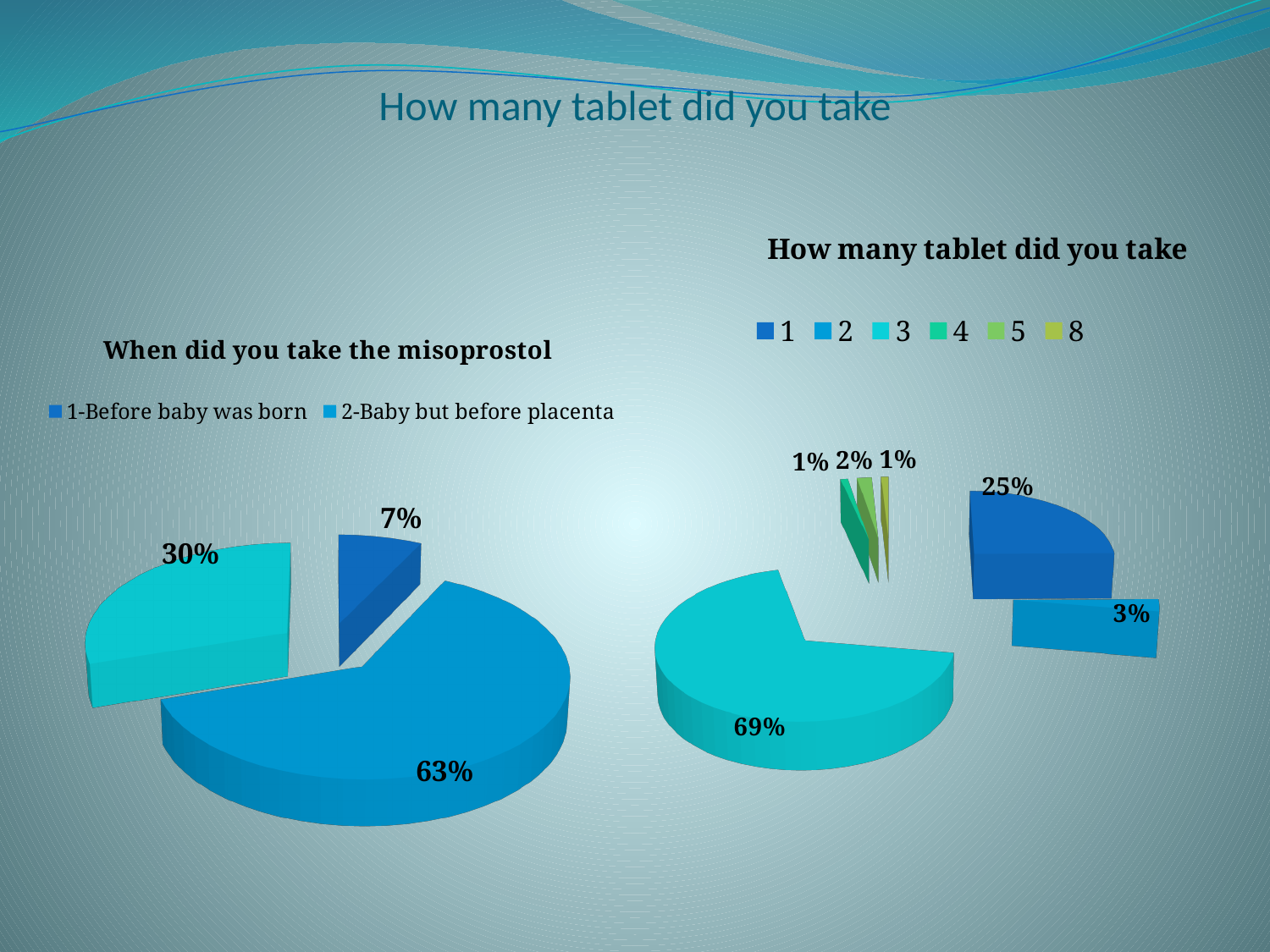
On the chart titled "When did you take the misoprostol", what share is shown for "1-Before baby was born"? 7% On the chart titled "When did you take the misoprostol", what share is shown for "2-Baby but before placenta"? 63% On the chart titled "How many tablet did you take", what share is shown for category 1? 25% What kind of chart is the one titled "When did you take the misoprostol"? Pie chart On the chart titled "How many tablet did you take", how many entries does the legend list? 6 On the chart titled "How many tablet did you take", which slice is larger: category 1 or category 2? Category 1 On the chart titled "When did you take the misoprostol", how many slices does the pie have? 3 On the chart titled "When did you take the misoprostol", which category has the largest slice? 2-Baby but before placenta On the chart titled "How many tablet did you take", which category has the largest slice? 3 On the chart titled "When did you take the misoprostol", how many percentage points larger is the "2-Baby but before placenta" slice than the "1-Before baby was born" slice? 56 percentage points